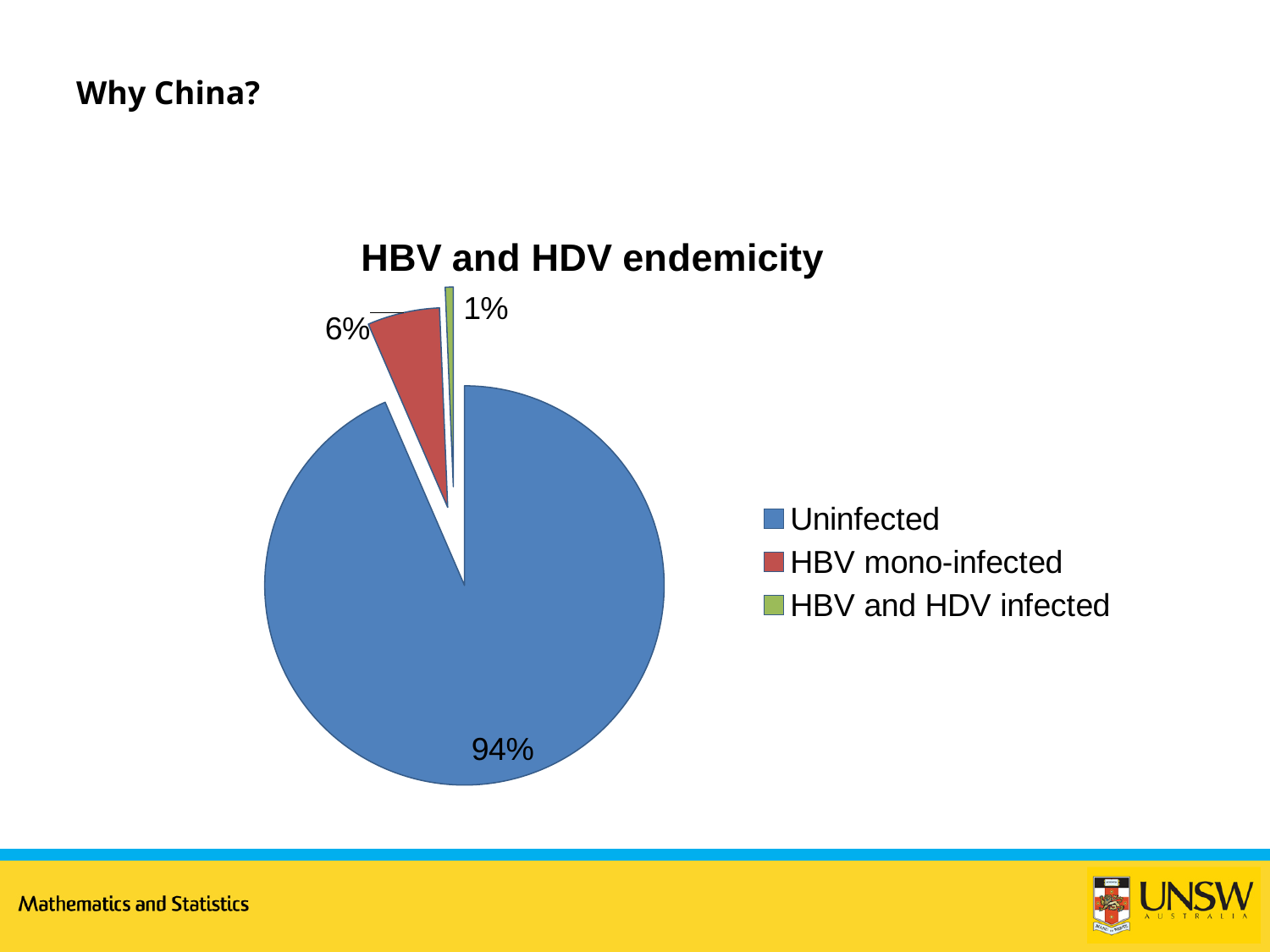
What kind of chart is shown on the slide? pie chart What is the difference between the HBV mono-infected share and the HBV and HDV infected share? 5% What is the difference between the Uninfected share and the HBV mono-infected share? 88% What share of the pie is HBV and HDV infected? 1% Which category has the largest slice of the pie? Uninfected What colour is the Uninfected slice? blue What share of the pie is Uninfected? 94% What is the title of the chart? HBV and HDV endemicity What share of the pie is HBV mono-infected? 6% Which category has the smallest slice of the pie? HBV and HDV infected How many categories does the pie chart show? 3 Which is larger, the HBV mono-infected slice or the HBV and HDV infected slice? HBV mono-infected